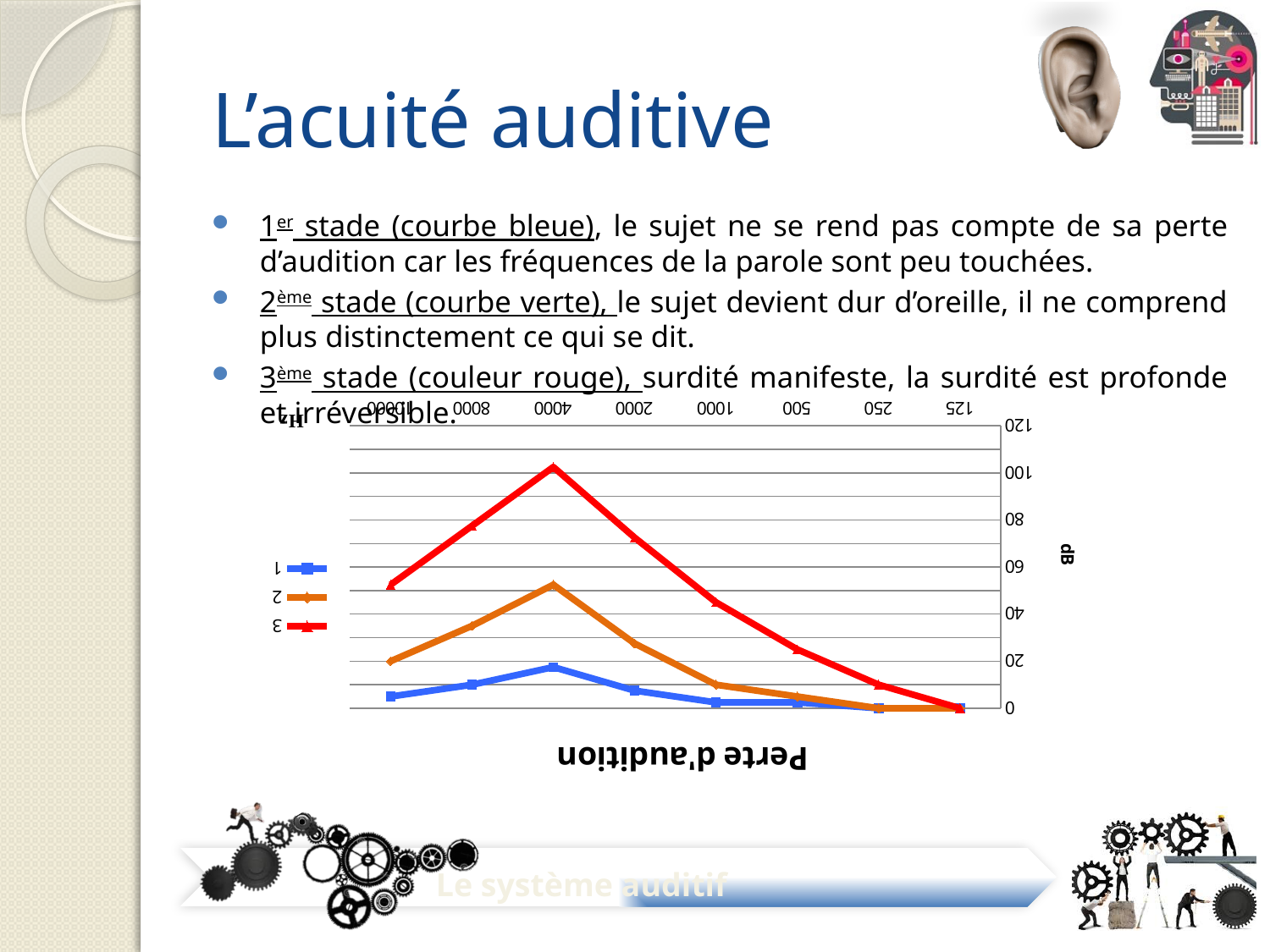
What is the label of the vertical axis of the chart? dB Is the value of series 3 at 4000 Hz greater or less than 80 dB? greater Is the value of series 2 at 4000 Hz greater or less than 60 dB? less At which frequency does series 3 reach its highest value? 4000 Is the value of series 3 at 2000 Hz greater or less than 60 dB? greater How many series does the chart legend list? 3 What kind of chart is shown on the slide? line chart Does the value of series 3 rise or fall from 125 Hz to 4000 Hz? rise Which series reaches the highest value on the chart? 3 What is the title of the chart? Perte d'audition At 2000 Hz, which series has the larger value, series 2 or series 3? 3